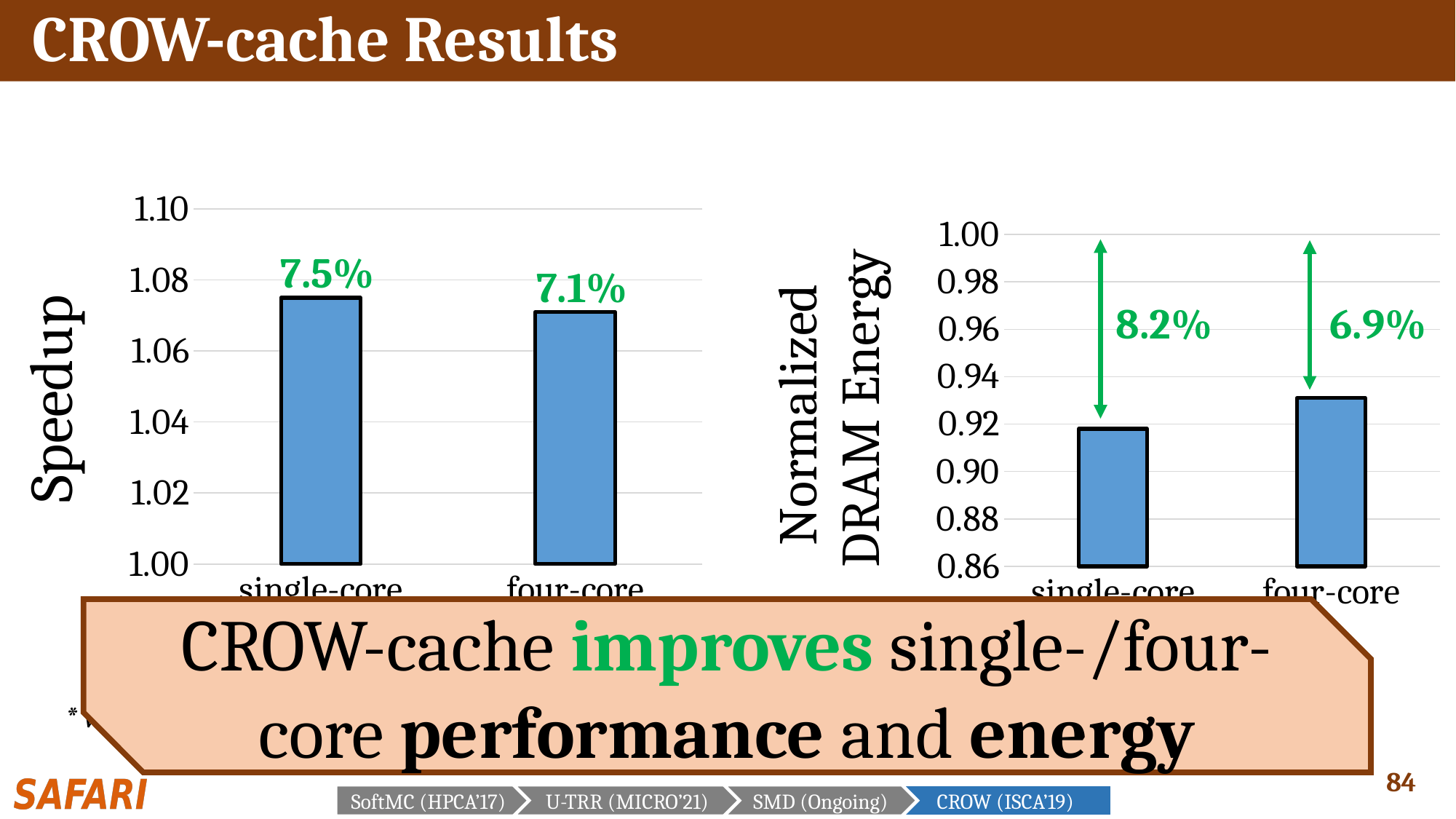
On the Normalized DRAM Energy chart, which category has the lower normalized energy? single-core How many bars are plotted on the Speedup chart? 2 On the Normalized DRAM Energy chart, is the value for four-core greater or less than 0.94? less What kind of chart is the Normalized DRAM Energy chart? bar chart On the Speedup chart, what percentage label is shown above the single-core bar? 7.5% On the Speedup chart, is the value for four-core greater or less than 1.06? greater On the Normalized DRAM Energy chart, what percentage is annotated for four-core? 6.9% On the Speedup chart, what percentage label is shown above the four-core bar? 7.1% On the Normalized DRAM Energy chart, is the value for single-core greater or less than 0.90? greater On the Normalized DRAM Energy chart, what percentage is annotated for single-core? 8.2% On the Speedup chart, which category has the higher speedup? single-core